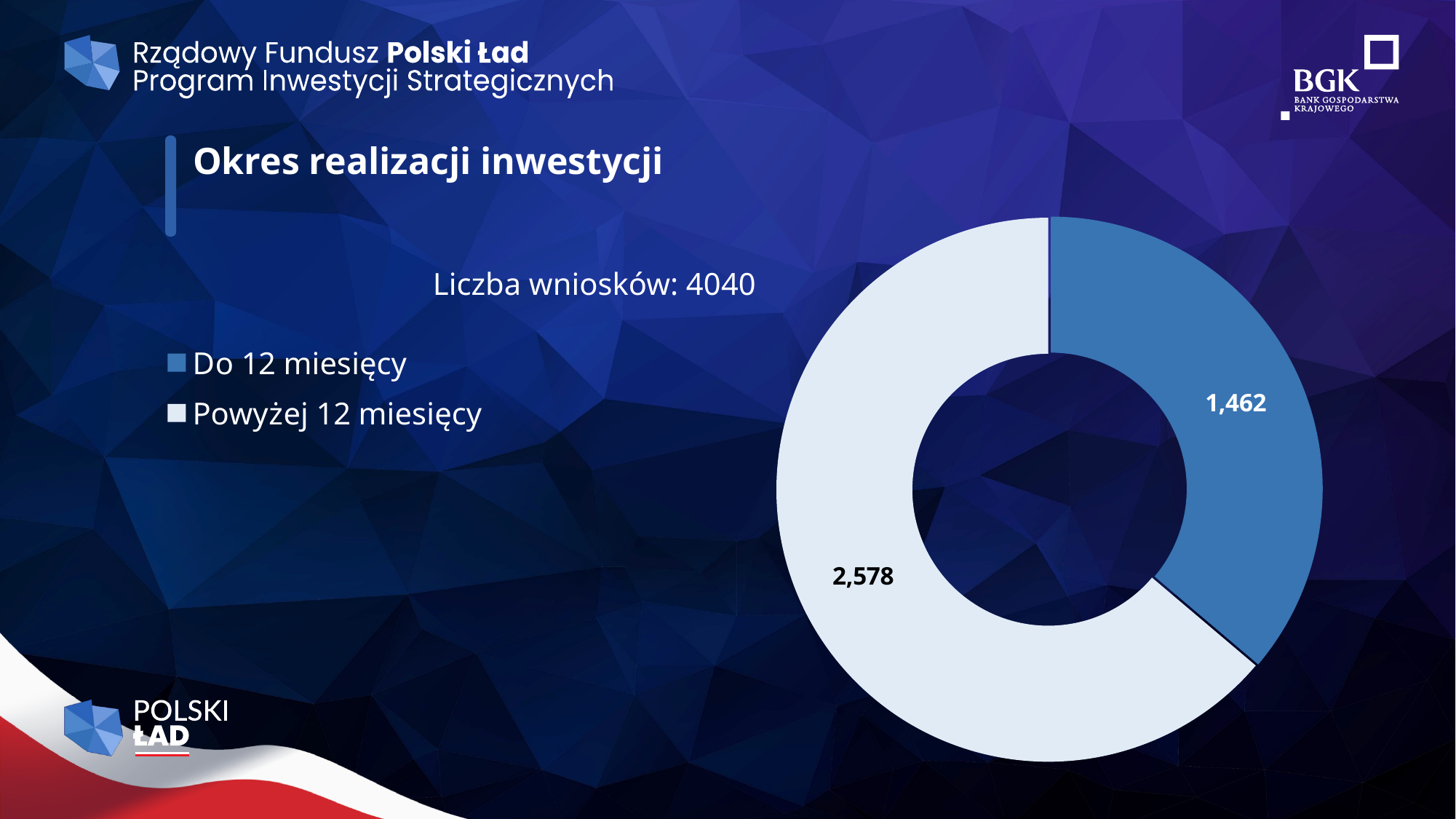
What is the value for "Do 12 miesięcy"? 1,462 What share of the total does "Do 12 miesięcy" represent? 36.2% Which category has the largest slice? Powyżej 12 miesięcy How many categories does the chart show? 2 What kind of chart is shown on the slide? Doughnut (pie) chart Which category has the smallest slice? Do 12 miesięcy What is the value for "Powyżej 12 miesięcy"? 2,578 What is the title of the chart? Okres realizacji inwestycji Which is larger: "Do 12 miesięcy" or "Powyżej 12 miesięcy"? Powyżej 12 miesięcy What colour is the slice for "Do 12 miesięcy"? Blue What is the total of the two slices in the chart? 4,040 What is the difference between the values for "Powyżej 12 miesięcy" and "Do 12 miesięcy"? 1,116